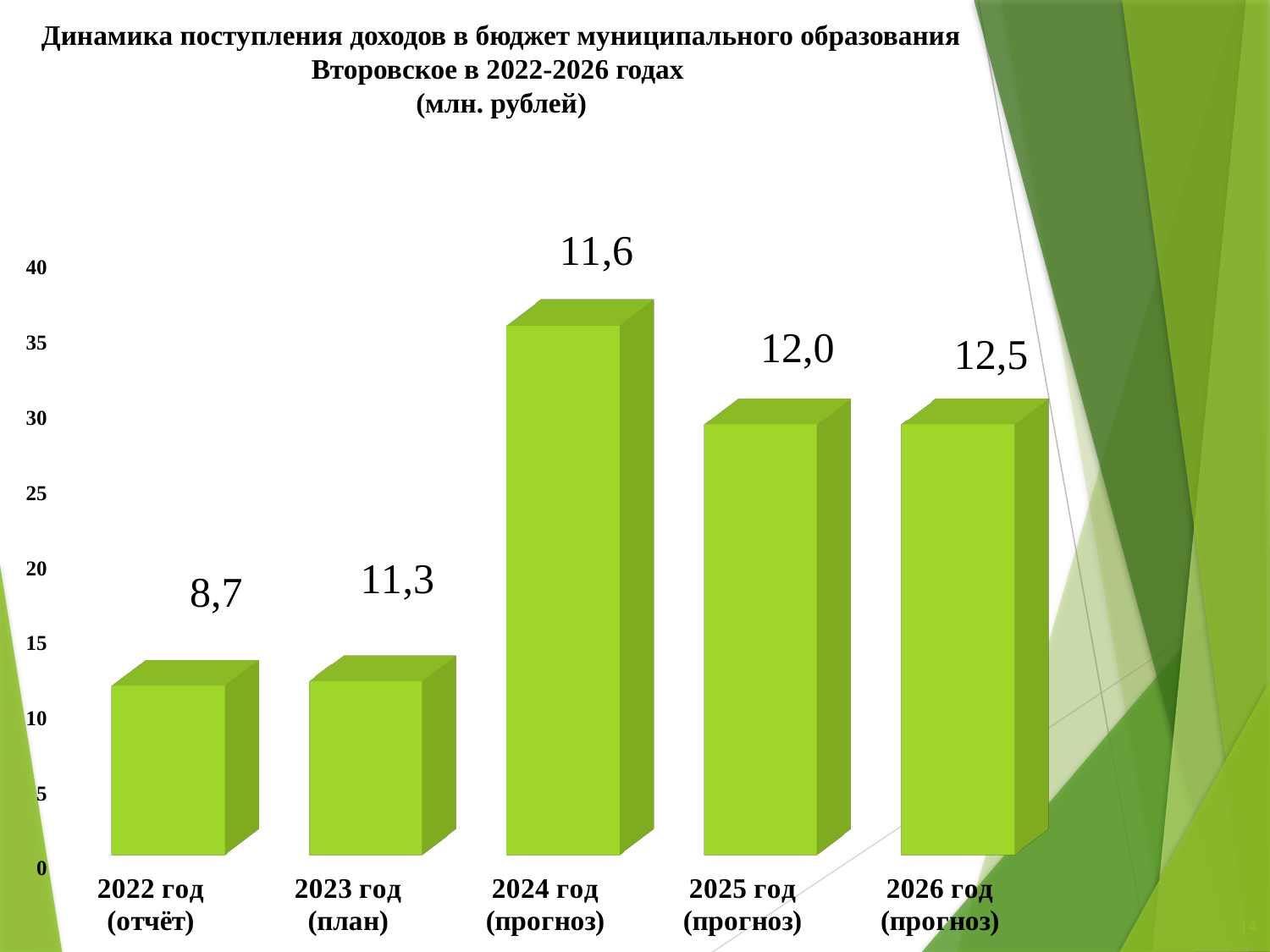
Which year has the lowest value? 2022 год (отчёт) What is the value for 2023 год (план)? 11,3 What is the value for 2026 год (прогноз)? 12,5 What is the value for 2025 год (прогноз)? 12,0 What kind of chart is shown on the slide? bar chart What is the value for 2024 год (прогноз)? 11,6 What is the difference between the values for 2026 год (прогноз) and 2025 год (прогноз)? 0,5 Which is larger, the value for 2022 год (отчёт) or for 2023 год (план)? 2023 год (план) What is the value for 2022 год (отчёт)? 8,7 What is the difference between the values for 2023 год (план) and 2022 год (отчёт)? 2,6 How many years are shown on the chart? 5 In what units are the values on the chart given, according to the title? млн. рублей